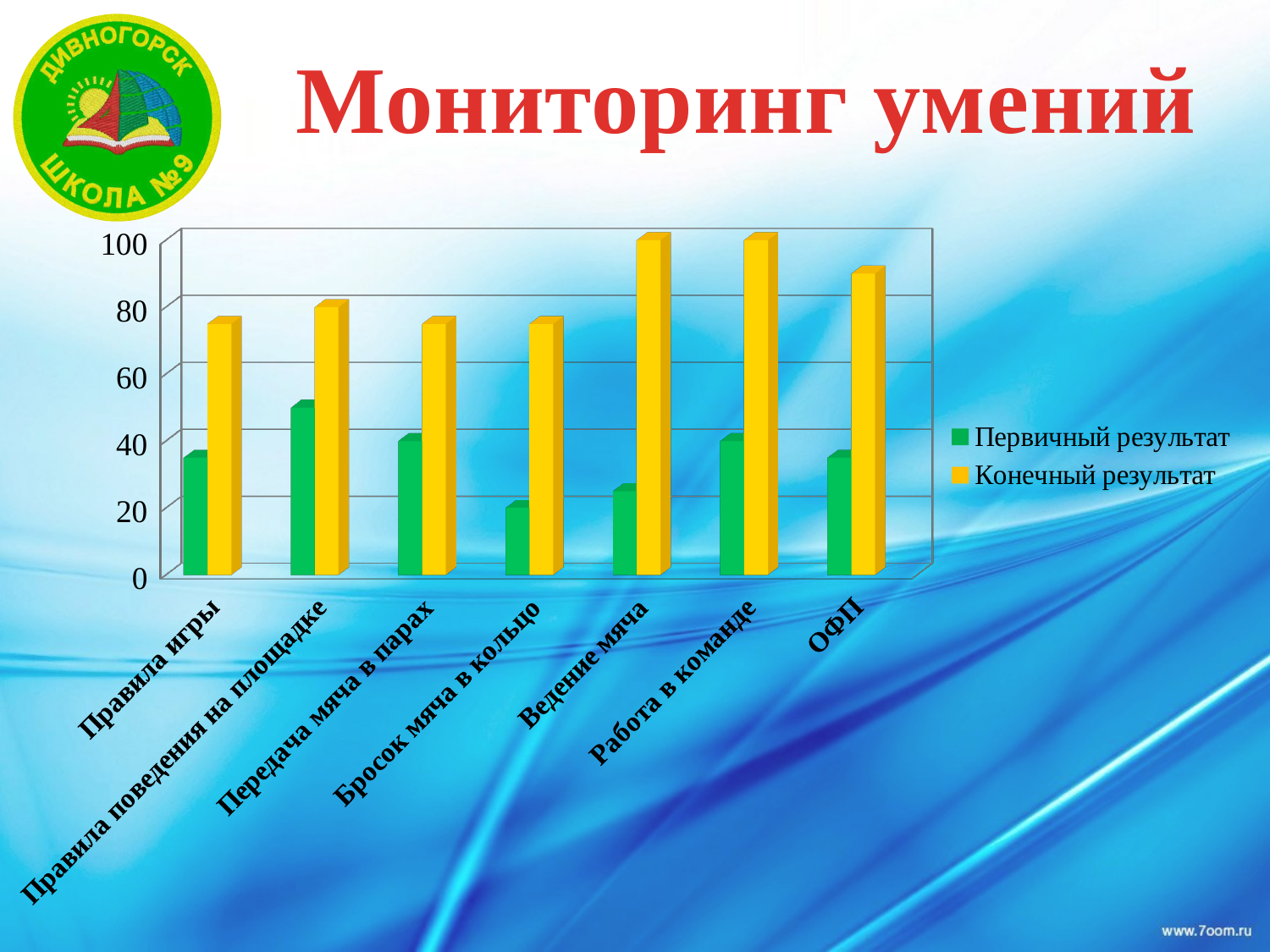
What kind of chart is shown on the slide? bar chart Which category has the lowest value for Первичный результат? Бросок мяча в кольцо How many categories are shown on the x axis of the chart? 7 Is the value of Первичный результат for Правила поведения на площадке greater or less than 40? greater Is the value of Первичный результат for Правила игры greater or less than 40? less What is the value of Конечный результат for Ведение мяча? 100 For Правила игры, which is larger: Первичный результат or Конечный результат? Конечный результат Is the value of Конечный результат for ОФП greater or less than 80? greater Which colour represents Конечный результат in the chart? yellow How many series does the chart legend list? 2 What is the value of Конечный результат for Работа в команде? 100 Which category has the highest value for Первичный результат? Правила поведения на площадке